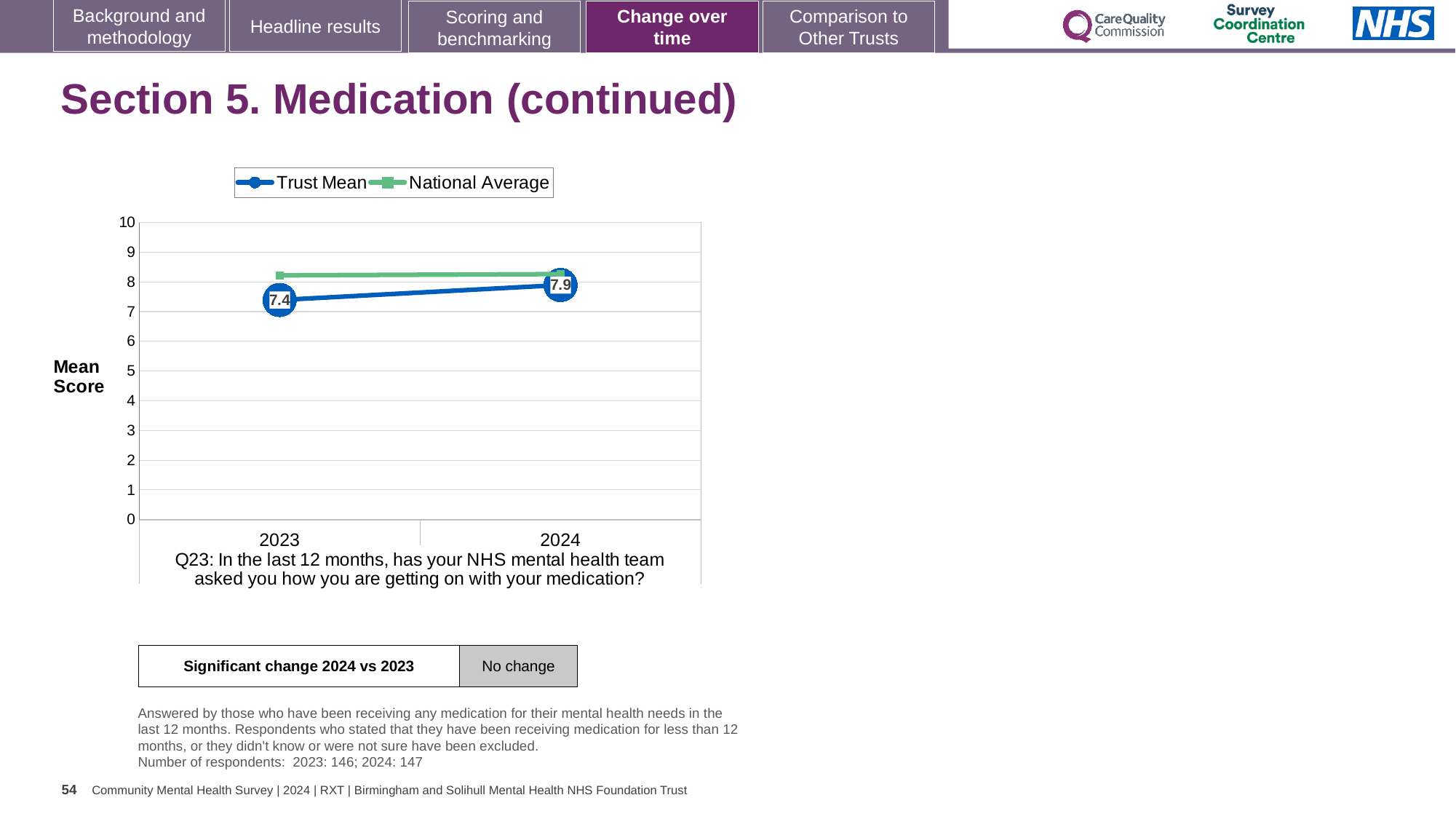
What kind of chart is shown on the slide? line chart Is the National Average value for 2024 greater or less than 8? greater What is the label of the y axis? Mean Score Which year has the higher Trust Mean, 2023 or 2024? 2024 How many series does the legend list? 2 In 2023, which is higher, the Trust Mean or the National Average? National Average By how much did the Trust Mean change from 2023 to 2024? 0.5 Is the National Average value for 2023 greater or less than 8? greater What is the Trust Mean value for 2024? 7.9 How many years are plotted on the x axis? 2 Does the Trust Mean rise or fall from 2023 to 2024? rise What is the Trust Mean value for 2023? 7.4